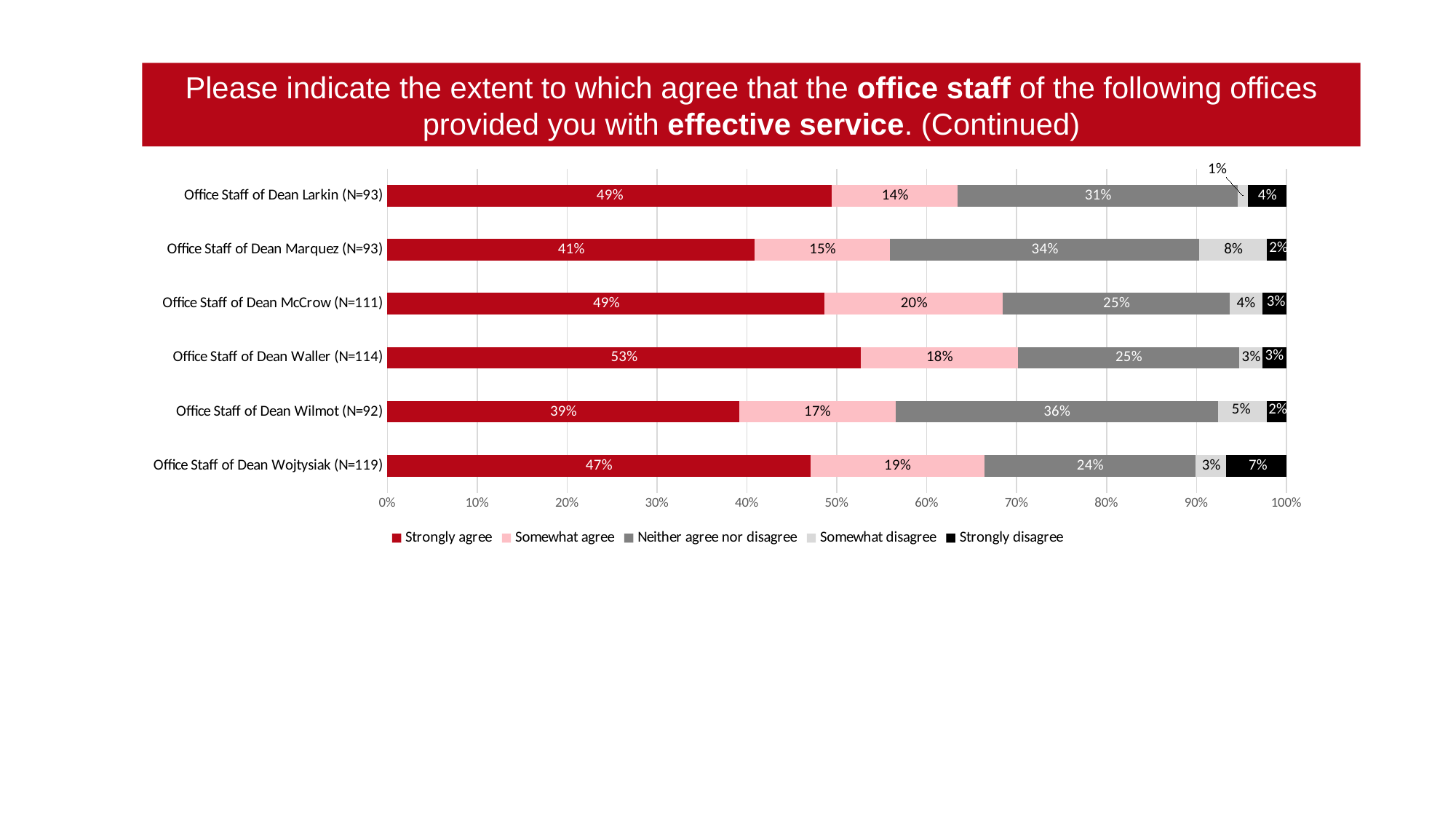
What is the 'Somewhat disagree' value for the Office Staff of Dean Marquez? 8% How many offices are shown in the chart? 6 What kind of chart is shown on the slide? Stacked bar chart What percentage of respondents strongly agree that the Office Staff of Dean Waller provided effective service? 53% Which office has the lowest 'Strongly agree' percentage? Office Staff of Dean Wilmot (N=92) Which is larger: the 'Somewhat agree' value for Dean McCrow or for Dean Larkin? Dean McCrow How many series does the legend list? 5 What is the 'Neither agree nor disagree' value for the Office Staff of Dean Wilmot? 36% What colour represents 'Strongly disagree' in the chart? Black What is the 'Strongly disagree' value for the Office Staff of Dean Wojtysiak? 7% What is the difference between the 'Strongly agree' values for Dean Waller and Dean Wilmot? 14% Which office has the highest 'Strongly agree' percentage? Office Staff of Dean Waller (N=114)